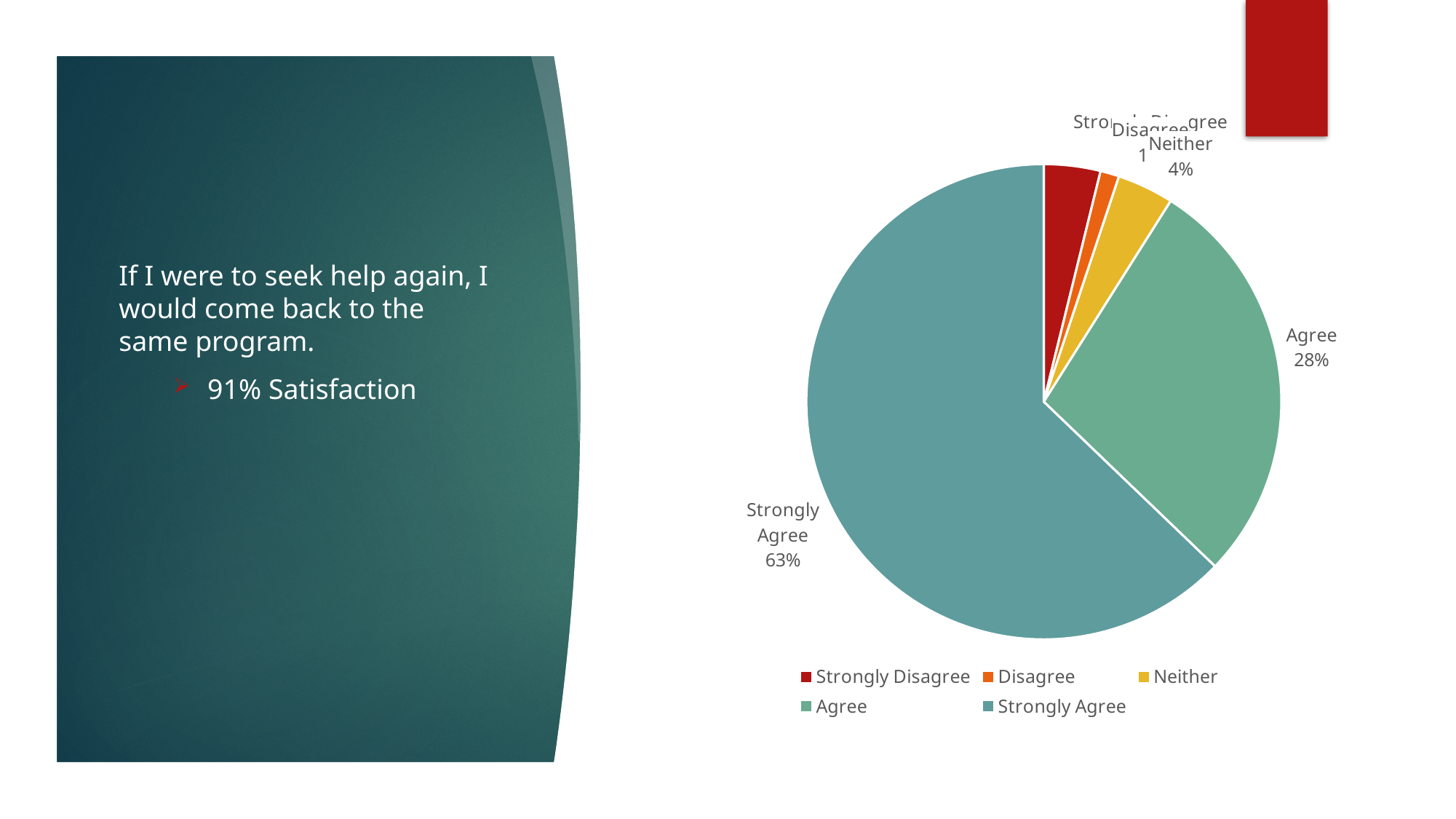
What is the difference in percentage points between Strongly Agree and Agree? 35 How many categories does the legend of the pie chart list? 5 Which slice is larger, Strongly Disagree or Disagree? Strongly Disagree Which slice is larger, Agree or Neither? Agree Which category has the smallest slice of the pie chart? Disagree What percentage of the pie chart is Neither? 4% What is the combined share of Strongly Agree and Agree? 91% What percentage of the pie chart is Agree? 28% What percentage of the pie chart is Strongly Agree? 63% What kind of chart is shown on the slide? Pie chart What colour is the Strongly Disagree slice in the pie chart? Dark red Which category has the largest slice of the pie chart? Strongly Agree